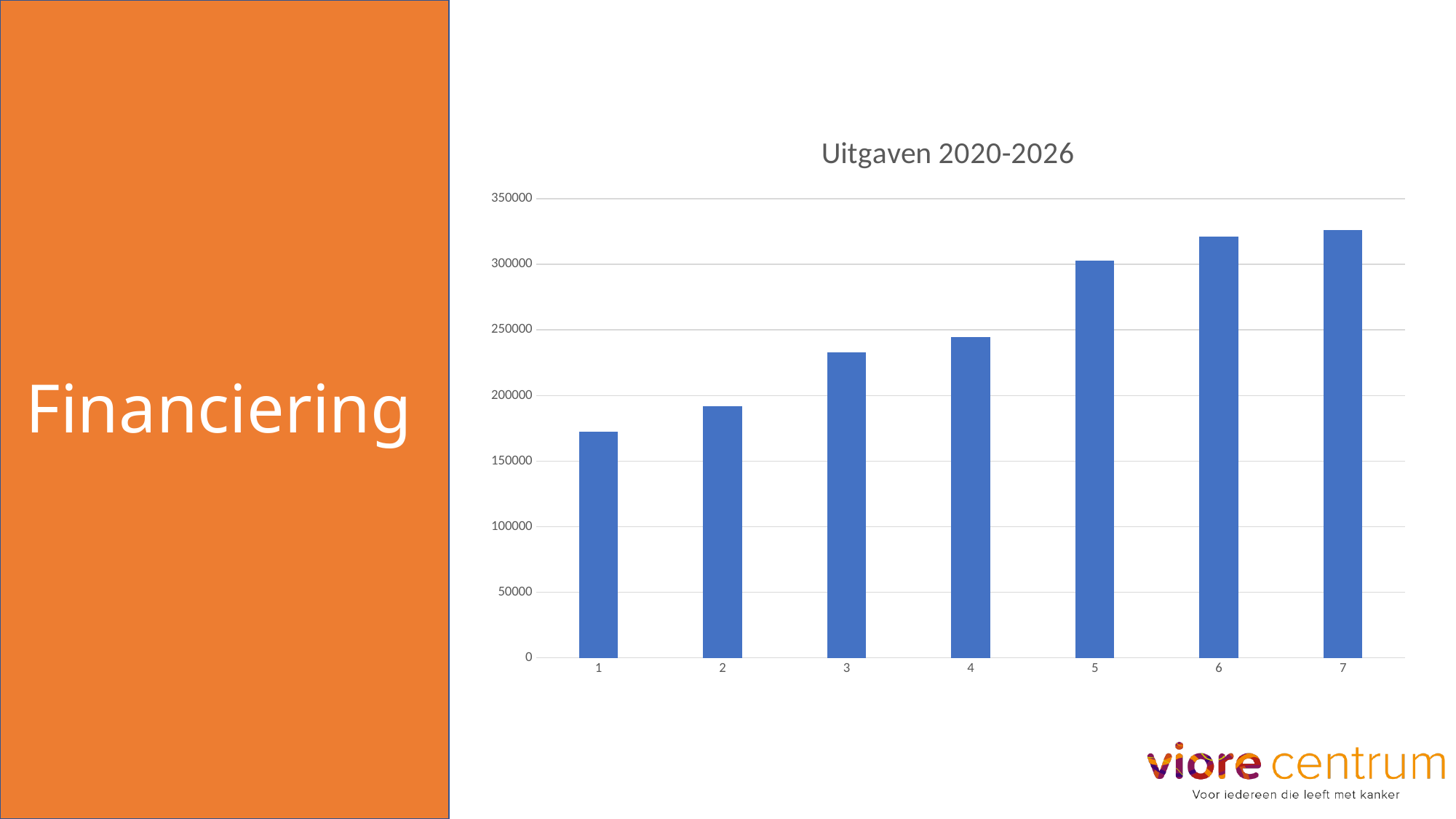
Which category has the lowest value? 1 Is the value for category 3 greater or less than 250000? less Do the values generally rise or fall from category 1 to category 7? rise What is the title of the chart? Uitgaven 2020-2026 Which is larger, the value for category 3 or category 5? 5 What kind of chart is shown on the slide? bar chart Is the value for category 1 greater or less than 200000? less Which is larger, the value for category 1 or category 2? 2 Is the value for category 5 greater or less than 250000? greater How many bars are plotted in the chart? 7